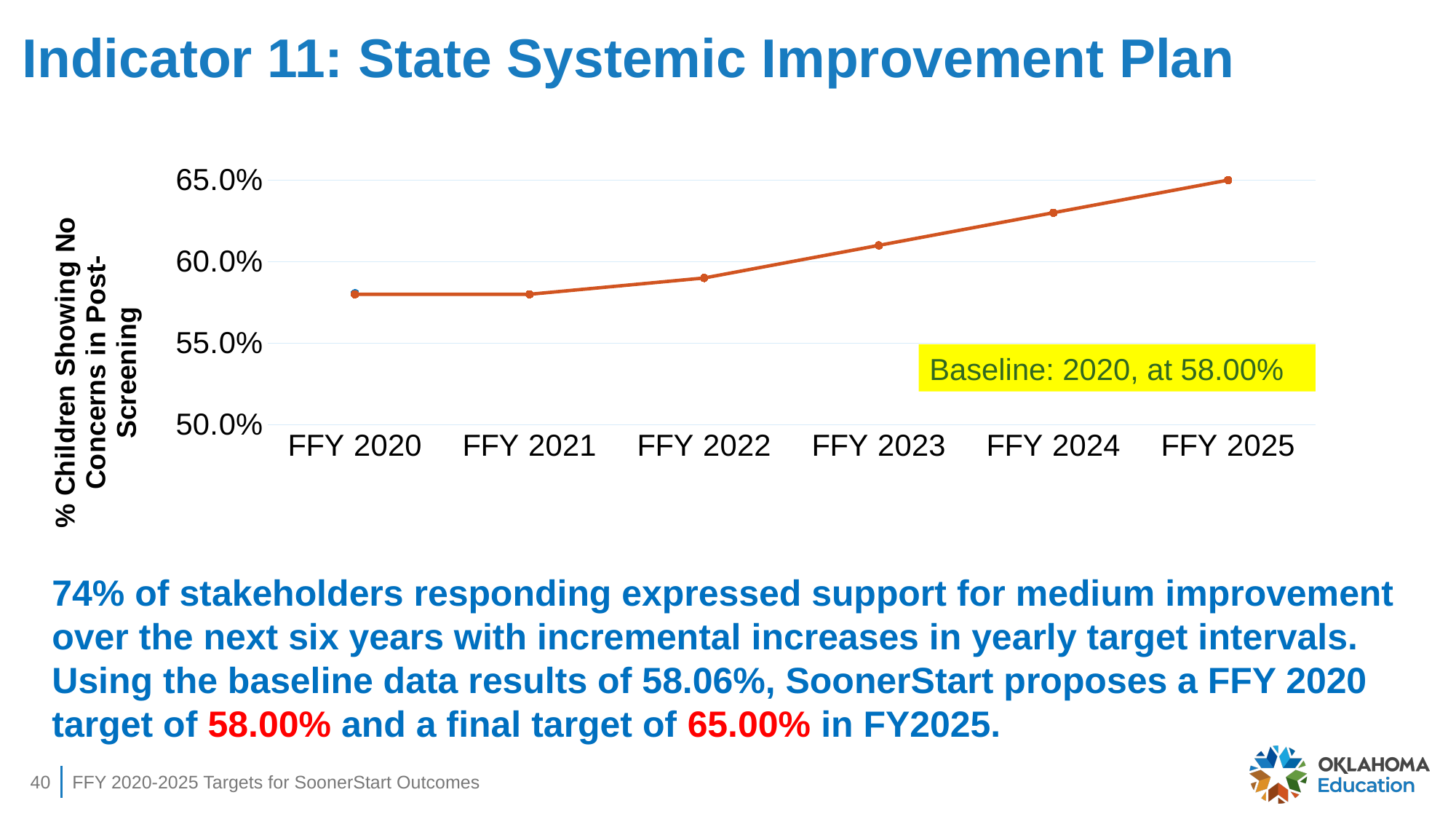
Is the value for FFY 2023 greater or less than 60.0%? greater Which is larger, the value for FFY 2024 or the value for FFY 2022? FFY 2024 Which fiscal year has the highest value on the chart? FFY 2025 What is the value for FFY 2025 on the chart? 65.0% What kind of chart is shown on the slide? line chart What is the baseline value for 2020 shown in the highlighted box on the chart? 58.00% Is the value for FFY 2024 greater or less than 65.0%? less Is the value for FFY 2022 greater or less than 60.0%? less How many fiscal years are plotted on the x axis? 6 What is the difference between the FFY 2025 target of 65.00% and the FFY 2020 baseline of 58.00%? 7.00% Do the values rise or fall from FFY 2020 to FFY 2025? rise What is the label on the y axis of the chart? % Children Showing No Concerns in Post-Screening